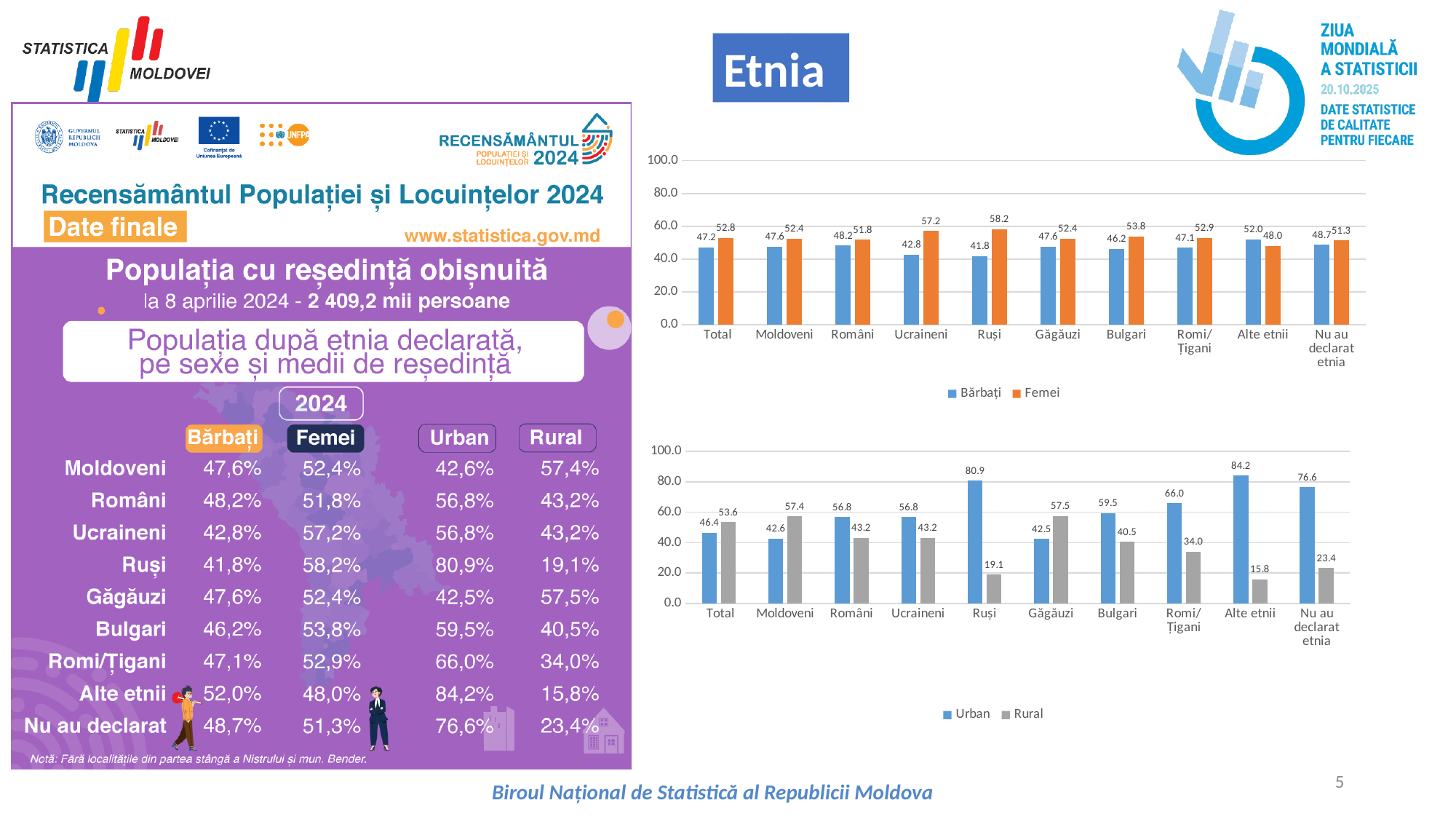
In the bottom chart, how many categories are shown on the x axis? 10 In the top chart, how many series does the legend list? 2 In the bottom chart, which category has the lowest Rural value? Alte etnii In the top chart, what is the difference between the Femei and Bărbați values for Bulgari? 7.6 In the bottom chart, what is the Rural value for Romi/Țigani? 34.0 In the top chart, what is the Bărbați value for Ucraineni? 42.8 In the bottom chart, what is the Urban value for Alte etnii? 84.2 In the top chart, which category has the highest Femei value? Ruși In the top chart, which category has the lowest Bărbați value? Ruși What kind of chart is the bottom chart? Bar chart In the bottom chart, is the Urban value for Moldoveni larger or the Rural value? Rural In the top chart, what is the Femei value for Ruși? 58.2